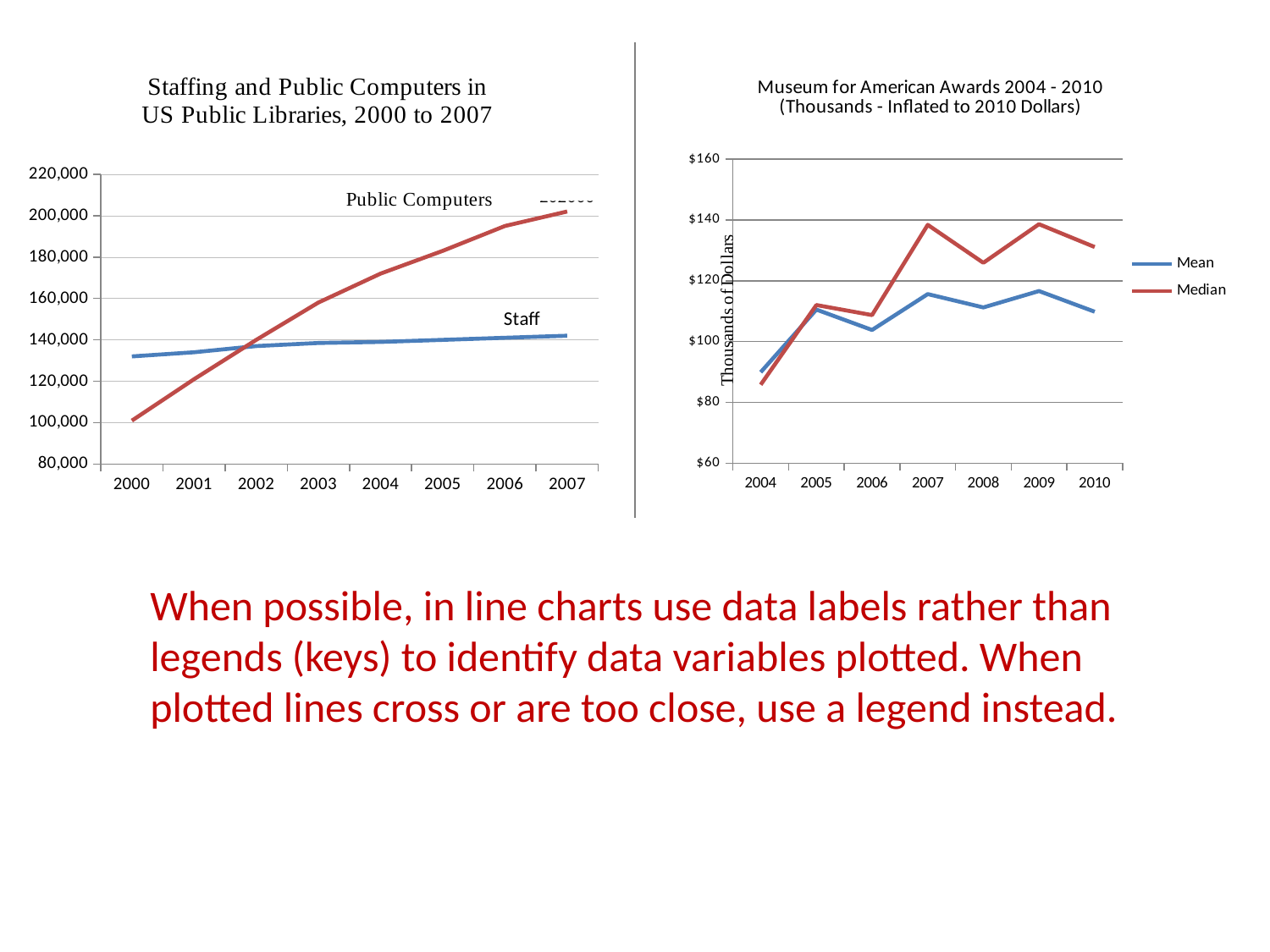
What kind of chart is the left chart, 'Staffing and Public Computers in US Public Libraries, 2000 to 2007'? line chart In the left chart, 'Staffing and Public Computers in US Public Libraries', how many years are shown on the x axis? 8 In the right chart, 'Museum for American Awards 2004 - 2010', which series has the higher value in 2008, Mean or Median? Median In the right chart, 'Museum for American Awards 2004 - 2010', what is the title of the vertical axis? Thousands of Dollars In the left chart, 'Staffing and Public Computers in US Public Libraries', is the value for Public Computers in 2007 greater or less than 180,000? greater In the left chart, 'Staffing and Public Computers in US Public Libraries', which series has the higher value in 2007, Staff or Public Computers? Public Computers In the left chart, 'Staffing and Public Computers in US Public Libraries', does the Public Computers line rise or fall from 2000 to 2007? rise In the left chart, 'Staffing and Public Computers in US Public Libraries', is the value for Public Computers in 2000 greater or less than 120,000? less In the left chart, 'Staffing and Public Computers in US Public Libraries', is the value for Staff in 2007 greater or less than 160,000? less In the left chart, 'Staffing and Public Computers in US Public Libraries', which series has the higher value in 2000, Staff or Public Computers? Staff In the right chart, 'Museum for American Awards 2004 - 2010', how many series does the legend list? 2